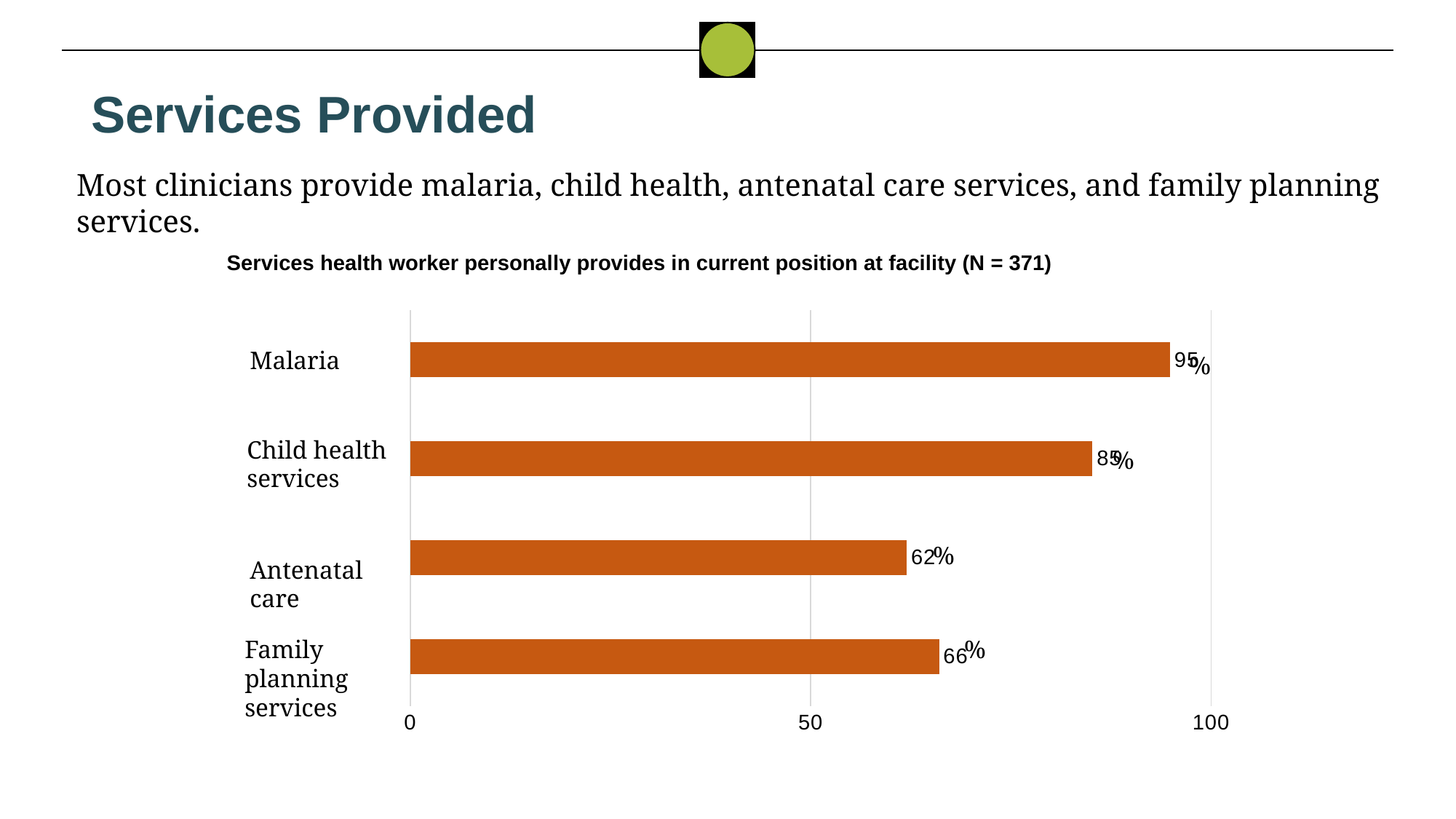
Which service is provided by the highest percentage of health workers? Malaria Which service is provided by the lowest percentage of health workers? Antenatal care Is the value for child health services greater or less than 50? greater How many services are shown in the chart? 4 What percentage of health workers personally provide malaria services? 95% What percentage of health workers personally provide antenatal care? 62% What percentage of health workers personally provide child health services? 85% What is the sample size (N) stated in the chart title? 371 What type of chart is used on this slide? Bar chart Which is larger: the percentage for family planning services or for antenatal care? Family planning services What is the difference in percentage points between malaria and child health services? 10 What percentage of health workers personally provide family planning services? 66%